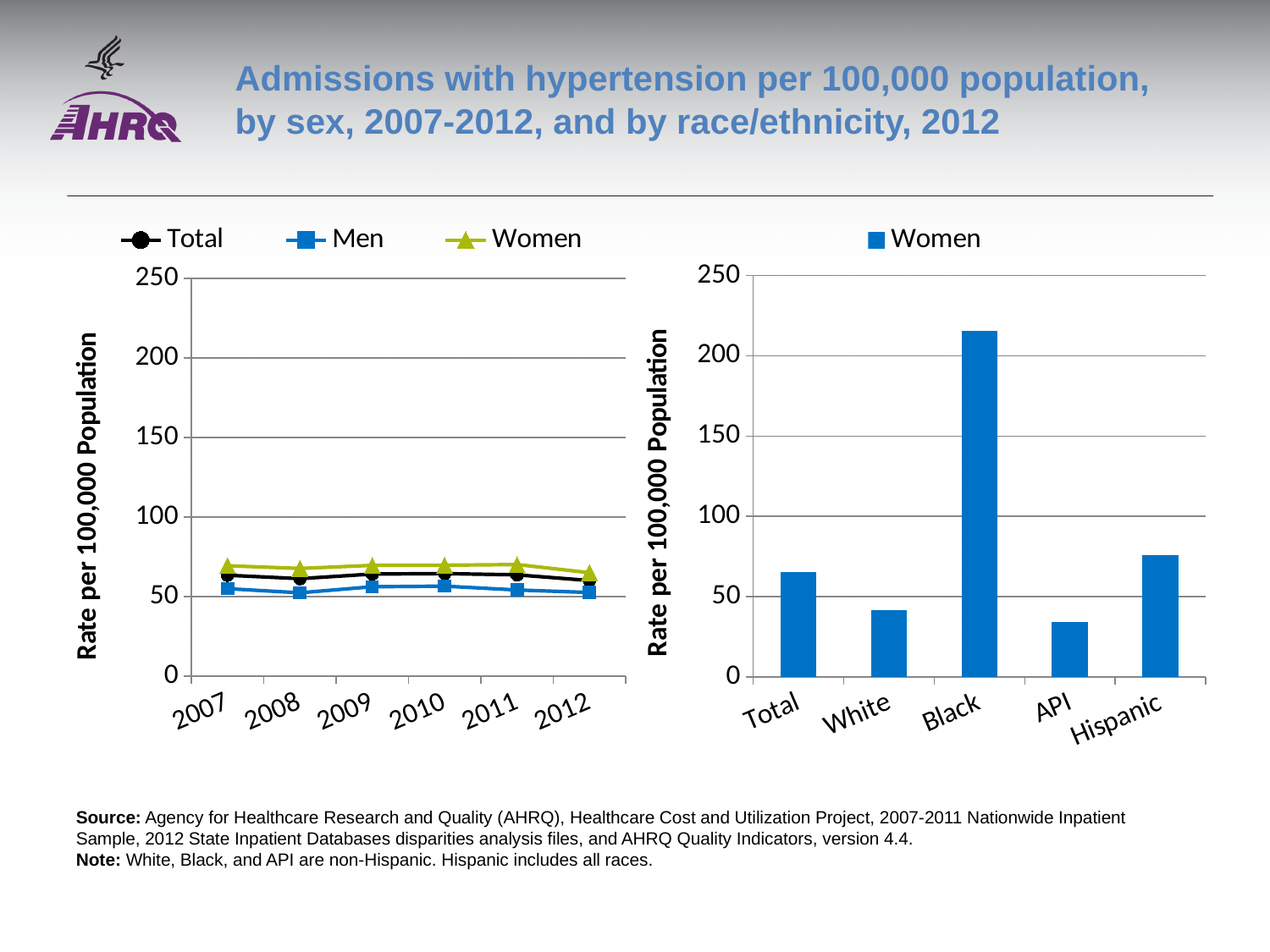
In the right-hand bar chart, which race/ethnicity category has the lowest rate? API In the right-hand bar chart, which race/ethnicity category has the highest rate? Black How many categories are shown on the x axis of the right-hand bar chart? 5 In the right-hand bar chart, is the value for Black greater or less than 200? greater How many years are shown on the x axis of the left-hand line chart? 6 In the left-hand line chart, is the value for Men in 2012 greater or less than 100? less What kind of chart is the chart on the right of the slide? bar chart What kind of chart is the chart on the left of the slide? line chart In the right-hand bar chart, is the value for Hispanic greater or less than 100? less In the right-hand bar chart, which is larger, the value for Hispanic or the value for White? Hispanic How many series does the legend of the left-hand line chart list? 3 In the left-hand line chart, which series is higher in 2012, Men or Women? Women